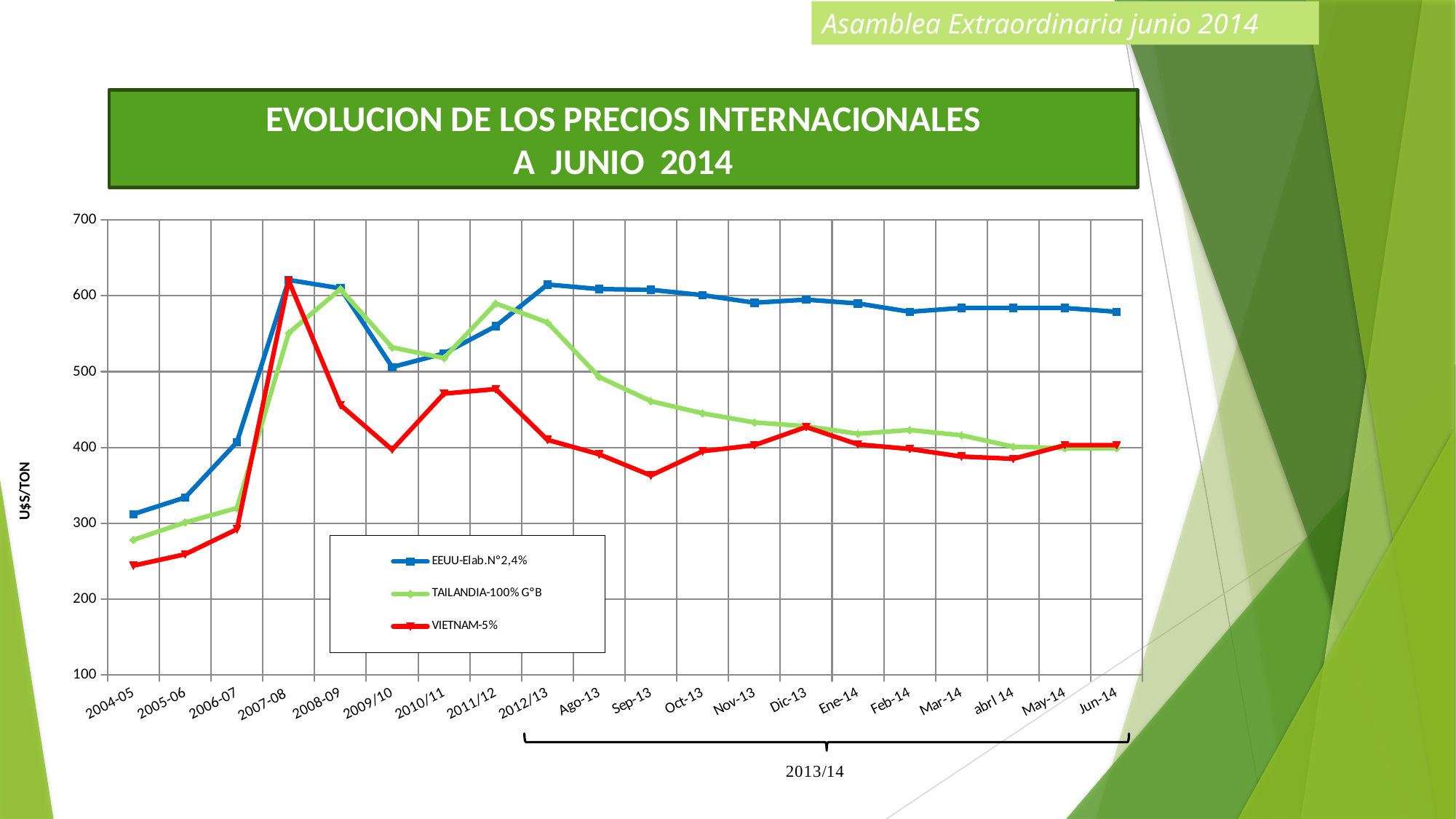
What is the title of the chart? EVOLUCION DE LOS PRECIOS INTERNACIONALES A JUNIO 2014 Is the value for VIETNAM-5% in 2004-05 greater or less than 300? less Is the value for TAILANDIA-100% G°B in 2011/12 greater or less than 500? greater What is the label on the y axis? U$S/TON Which series has the highest value in Jun-14? EEUU-Elab.N°2,4% In which category does VIETNAM-5% reach its highest value? 2007-08 Does the value for EEUU-Elab.N°2,4% rise or fall from 2004-05 to 2007-08? rise How many categories are shown on the x axis? 20 Is the value for VIETNAM-5% in Sep-13 greater or less than 400? less What kind of chart is shown on the slide? line chart How many series does the legend list? 3